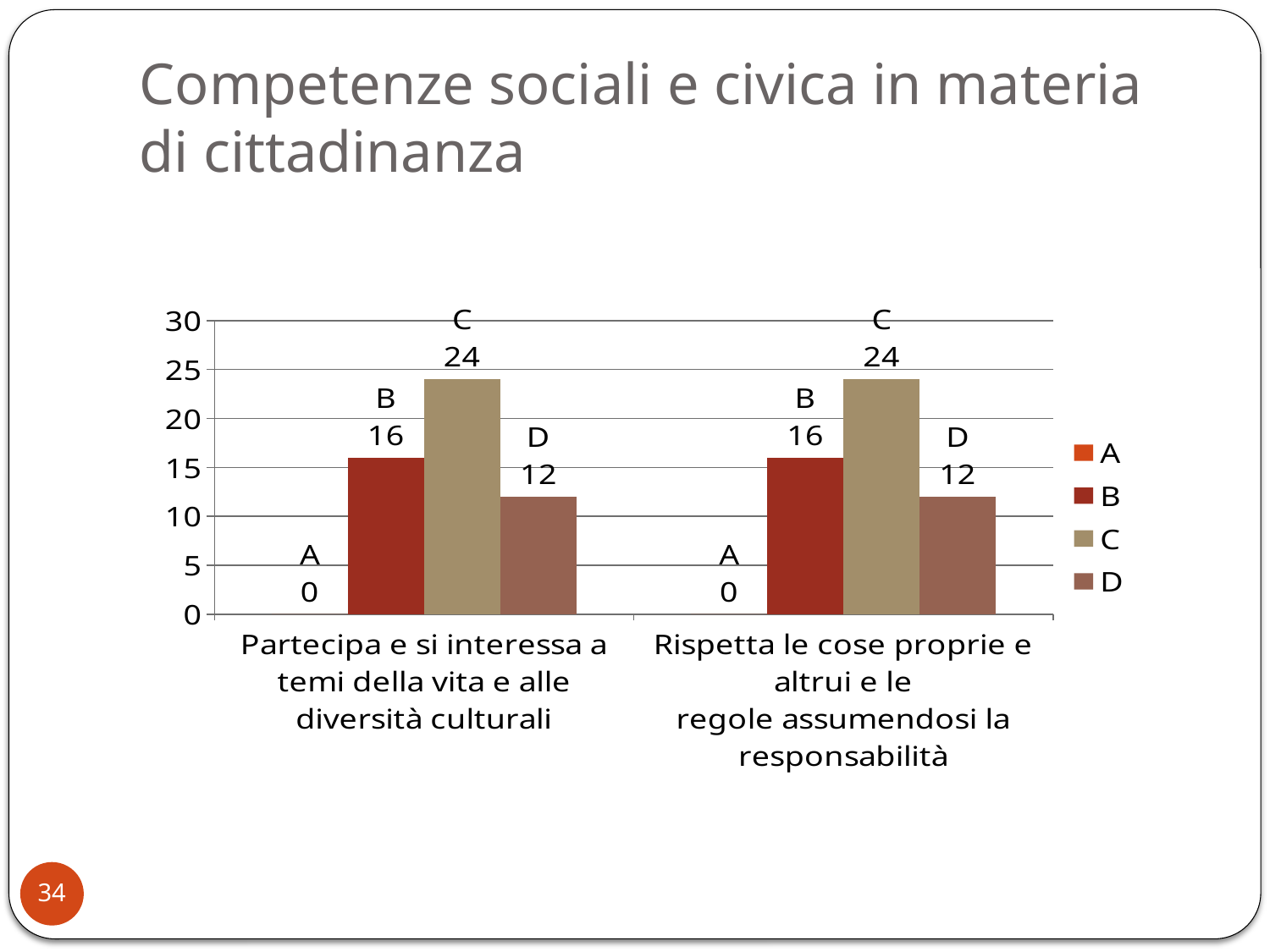
What is the difference between the values of series C and series D for the category 'Partecipa e si interessa a temi della vita e alle diversità culturali'? 12 What is the value of series B for the category 'Rispetta le cose proprie e altrui e le regole assumendosi la responsabilità'? 16 How many series does the legend list? 4 What kind of chart is shown on the slide? Bar chart What is the value of series A for the category 'Partecipa e si interessa a temi della vita e alle diversità culturali'? 0 Which series has the highest value for the category 'Partecipa e si interessa a temi della vita e alle diversità culturali'? C What is the value of series C for the category 'Partecipa e si interessa a temi della vita e alle diversità culturali'? 24 What is the value of series D for the category 'Rispetta le cose proprie e altrui e le regole assumendosi la responsabilità'? 12 What is the total of the values for series B, C and D in the category 'Partecipa e si interessa a temi della vita e alle diversità culturali'? 52 Which is larger for the category 'Rispetta le cose proprie e altrui e le regole assumendosi la responsabilità': series B or series D? B How many categories are shown on the x axis? 2 Which series has the lowest value for the category 'Rispetta le cose proprie e altrui e le regole assumendosi la responsabilità'? A